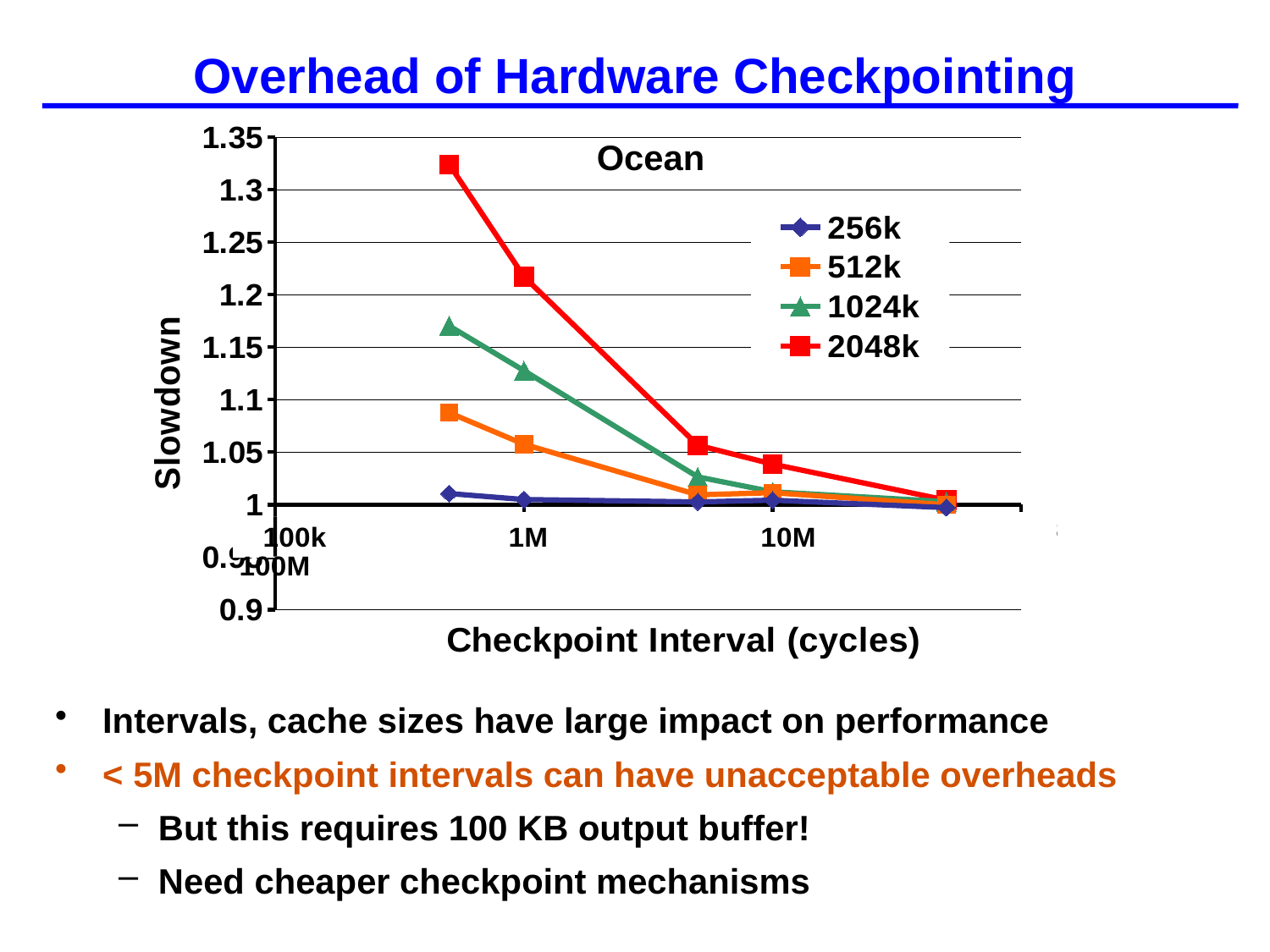
What is the title shown inside the chart? Ocean At the leftmost point, which series has the larger slowdown, 512k or 1024k? 1024k Is the leftmost value for the 2048k series greater or less than 1.3? greater What is the label of the y axis? Slowdown Is the leftmost value for the 1024k series greater or less than 1.15? greater Which series has the highest slowdown at the shortest checkpoint interval (leftmost point)? 2048k What kind of chart is shown on the slide? line chart Is the leftmost value for the 512k series greater or less than 1.1? less Does the slowdown for the 2048k series rise or fall as the checkpoint interval increases along the x axis? fall Which series has the lowest slowdown at the shortest checkpoint interval (leftmost point)? 256k How many series does the legend list? 4